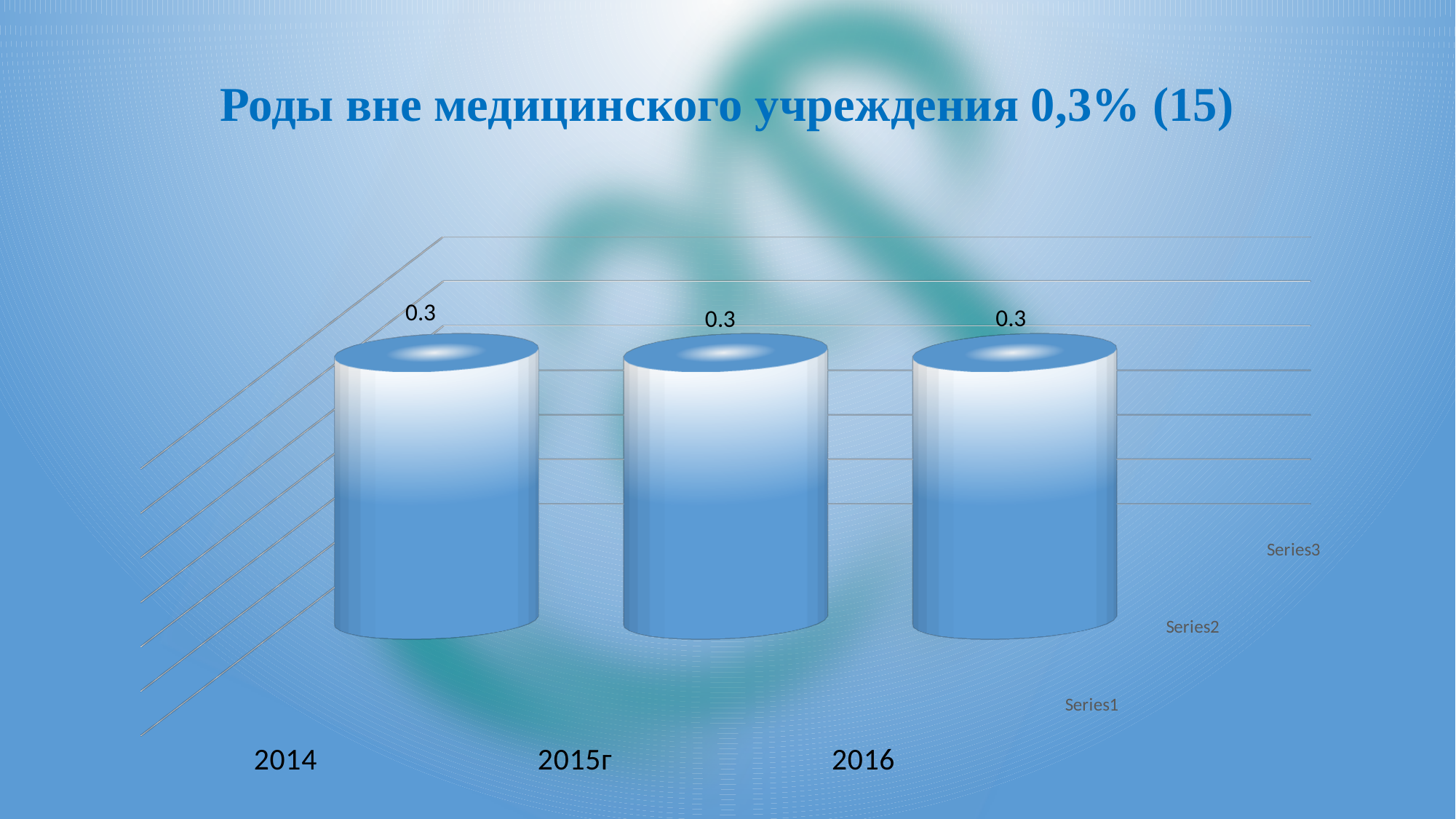
What kind of chart is shown on the slide? bar chart What is the label of the first category on the x axis? 2014 What is the title of the chart? Роды вне медицинского учреждения 0,3% (15) What is the difference between the values for 2015г and 2016? 0 What is the value for 2014? 0.3 How many categories are shown on the x axis? 3 What is the value for 2015г? 0.3 Do the values rise, fall or stay the same from 2014 to 2016? stay the same What is the value for 2016? 0.3 Is the value for 2014 larger than, smaller than or equal to the value for 2016? equal